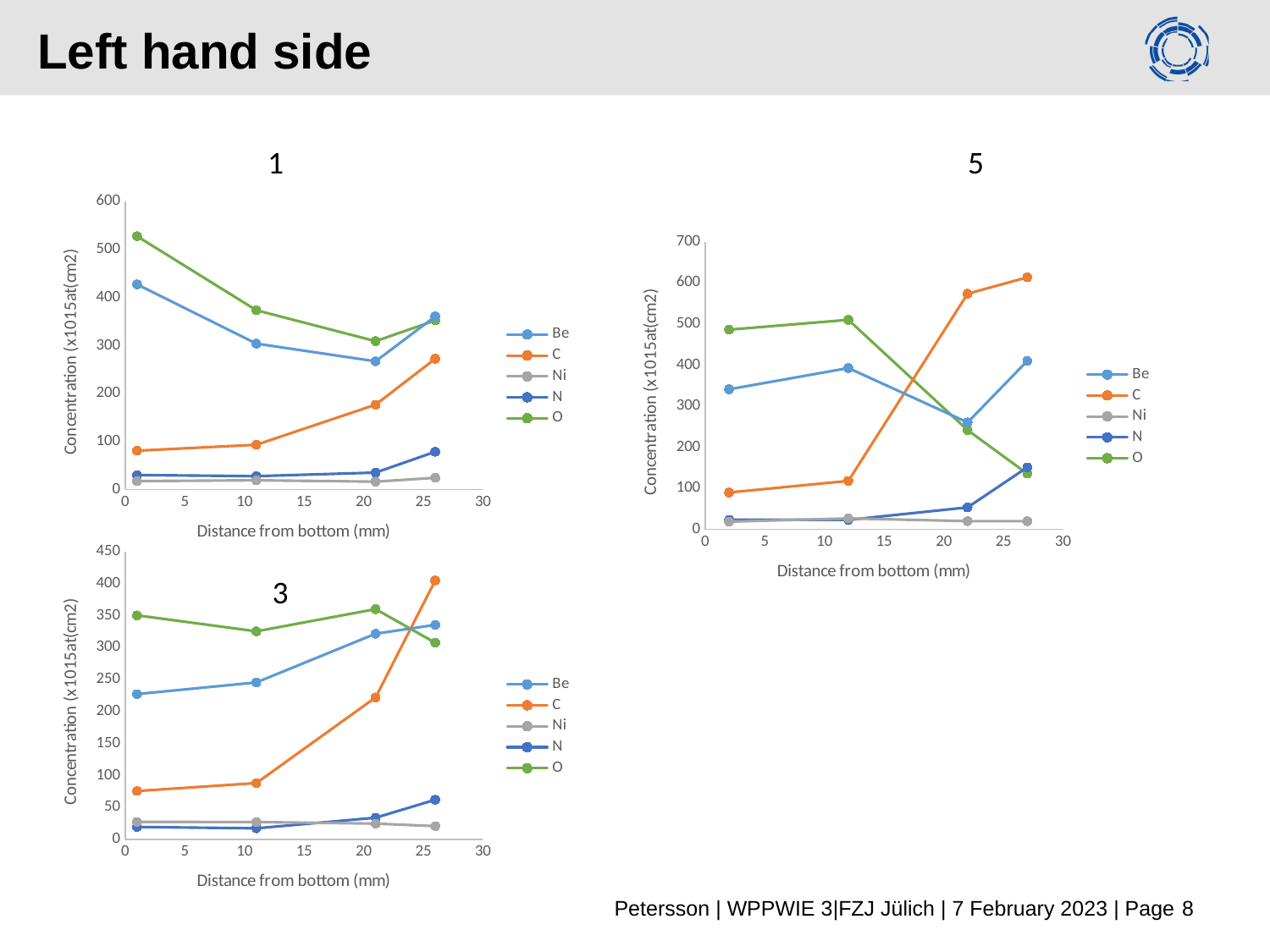
In the chart titled 5, which series has the lowest value at the last distance point (about 27 mm)? Ni In the chart titled 5, is the value of O at the last distance point (about 27 mm) greater or less than 200? less In the chart titled 1, overall does the O series rise or fall from left to right? fall In the chart titled 3, does the C series rise or fall along the x axis? rise In the chart titled 3, is the value of C at the last distance point (about 26 mm) greater or less than 350? greater What is the x-axis title of the chart titled 5? Distance from bottom (mm) In the chart titled 5, which series has the highest value at the last distance point (about 27 mm)? C In the chart titled 1, which series has the highest value at the first distance point (near 0 mm)? O In the chart titled 3, at the first distance point, which is larger: Be or O? O What kind of chart is the chart titled 1? line chart In the chart titled 1, how many series does the legend list? 5 In the chart titled 1, how many data points does each series have? 4